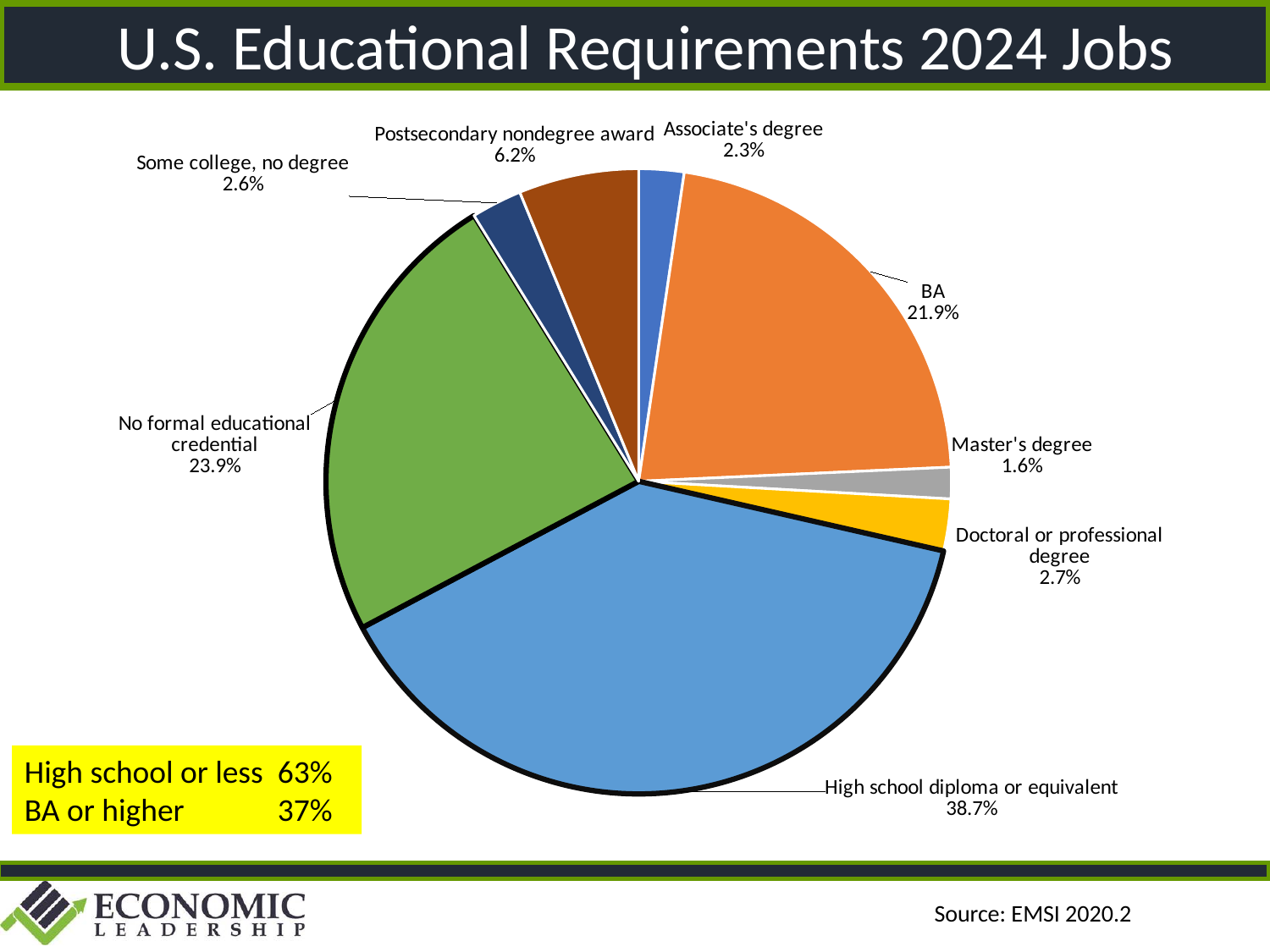
Which educational requirement has the smallest share of 2024 jobs? Master's degree What share of 2024 jobs requires a high school diploma or equivalent? 38.7% What is the combined share of the BA and Master's degree slices? 23.5% What is the difference in percentage points between the High school diploma or equivalent slice and the No formal educational credential slice? 14.8 Which is larger: the share for Doctoral or professional degree or the share for Associate's degree? Doctoral or professional degree Which educational requirement has the largest share of 2024 jobs? High school diploma or equivalent What share of 2024 jobs requires a Master's degree? 1.6% What kind of chart is shown on the slide? Pie chart What share of 2024 jobs requires a postsecondary nondegree award? 6.2% How many slices does the pie chart have? 8 What is the title of the chart on the slide? U.S. Educational Requirements 2024 Jobs What share of 2024 jobs requires a BA? 21.9%